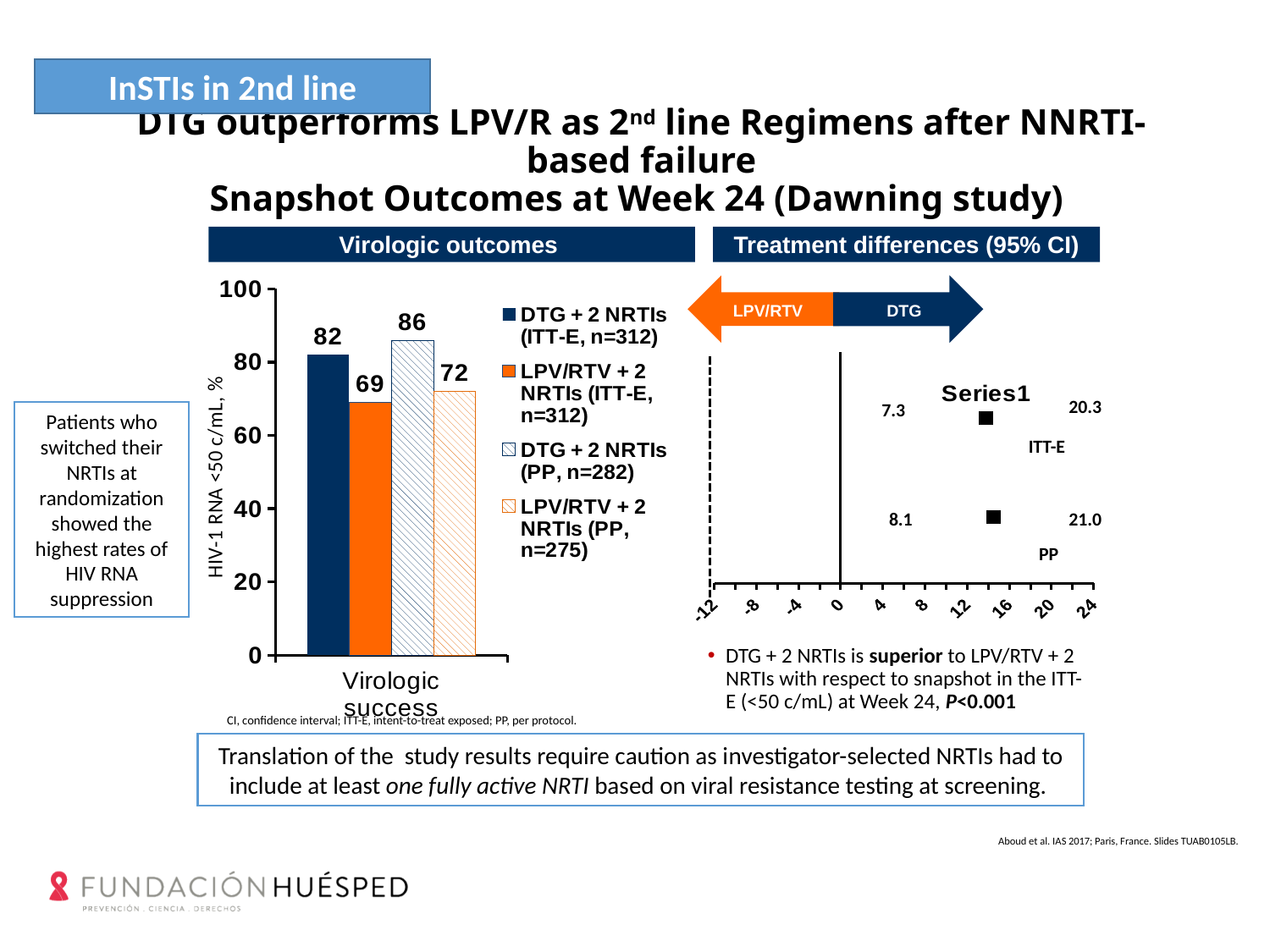
In the Virologic outcomes chart, how many series does the legend list? 4 In the Virologic outcomes chart, what is the label on the y axis? HIV-1 RNA <50 c/mL, % In the Virologic outcomes chart, what is the value for LPV/RTV + 2 NRTIs (PP, n=275)? 72 In the Virologic outcomes chart, what is the difference between DTG + 2 NRTIs (ITT-E) and LPV/RTV + 2 NRTIs (ITT-E)? 13 In the Virologic outcomes chart, what is the value for LPV/RTV + 2 NRTIs (ITT-E, n=312)? 69 In the Virologic outcomes chart, what is the difference between DTG + 2 NRTIs (PP) and LPV/RTV + 2 NRTIs (PP)? 14 In the Virologic outcomes chart, which series has the highest value? DTG + 2 NRTIs (PP, n=282) In the Treatment differences (95% CI) chart, what are the lower and upper confidence limits shown for ITT-E? 7.3 and 20.3 What kind of chart is the Virologic outcomes chart? bar chart In the Virologic outcomes chart, what is the value for DTG + 2 NRTIs (PP, n=282)? 86 In the Virologic outcomes chart, which series has the lowest value? LPV/RTV + 2 NRTIs (ITT-E, n=312) In the Virologic outcomes chart, what is the value for DTG + 2 NRTIs (ITT-E, n=312)? 82